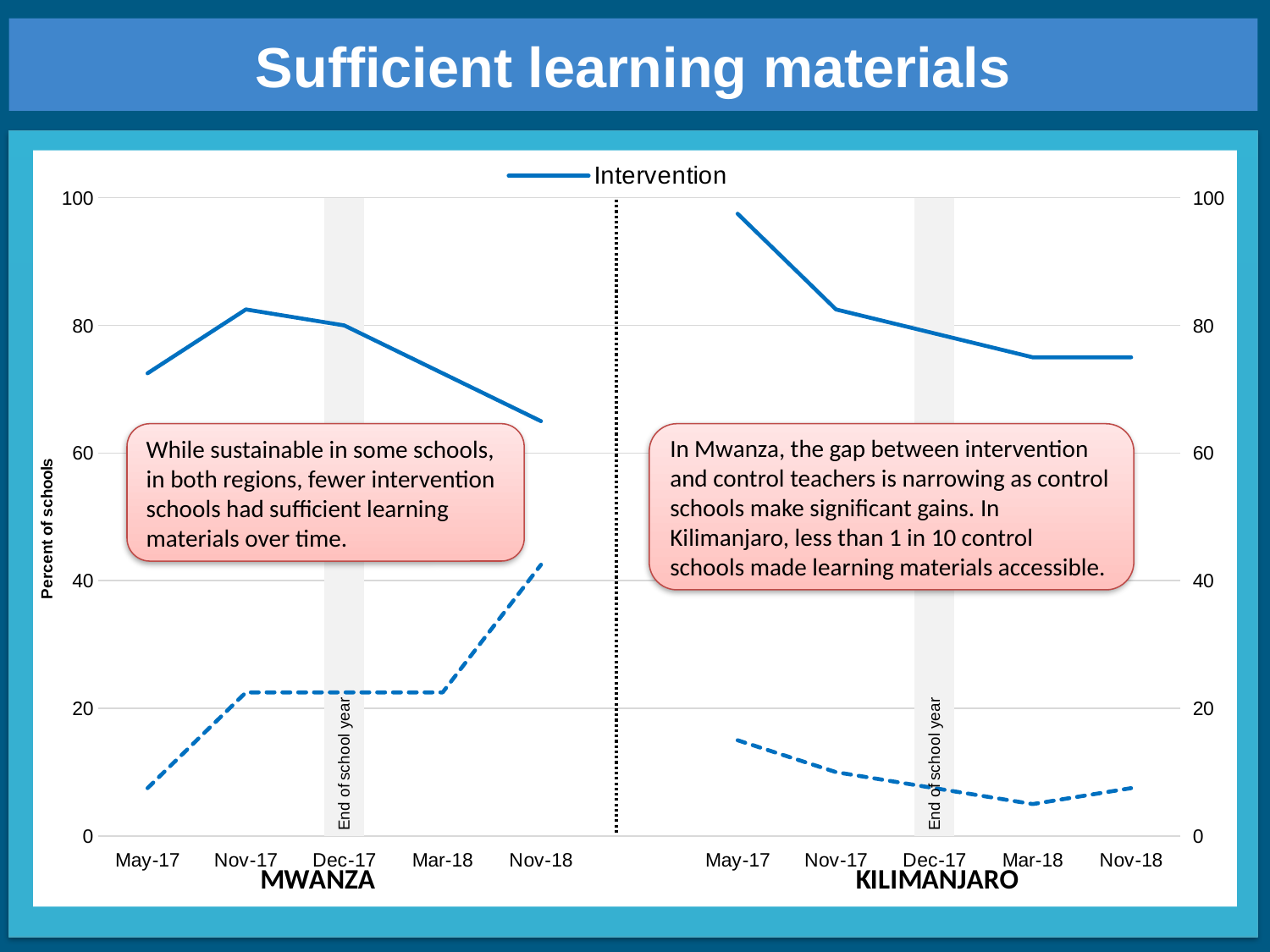
What is the label on the vertical axis of the chart? Percent of schools In the MWANZA panel, is the Intervention value for Nov-18 greater or less than 80? less In the KILIMANJARO panel, is the Intervention value for Nov-18 greater or less than 80? less In the MWANZA panel, at which date is the Intervention line lowest? Nov-18 In the KILIMANJARO panel, does the Intervention line rise or fall from May-17 to Nov-18? fall What kind of chart is shown on the slide? line chart Which panel has the higher Intervention value at May-17, MWANZA or KILIMANJARO? KILIMANJARO How many series does the chart legend list? 1 In the KILIMANJARO panel, is the Intervention value for May-17 greater or less than 80? greater In the MWANZA panel, at which date is the Intervention line highest? Nov-17 How many date labels appear on the x axis of the MWANZA panel? 5